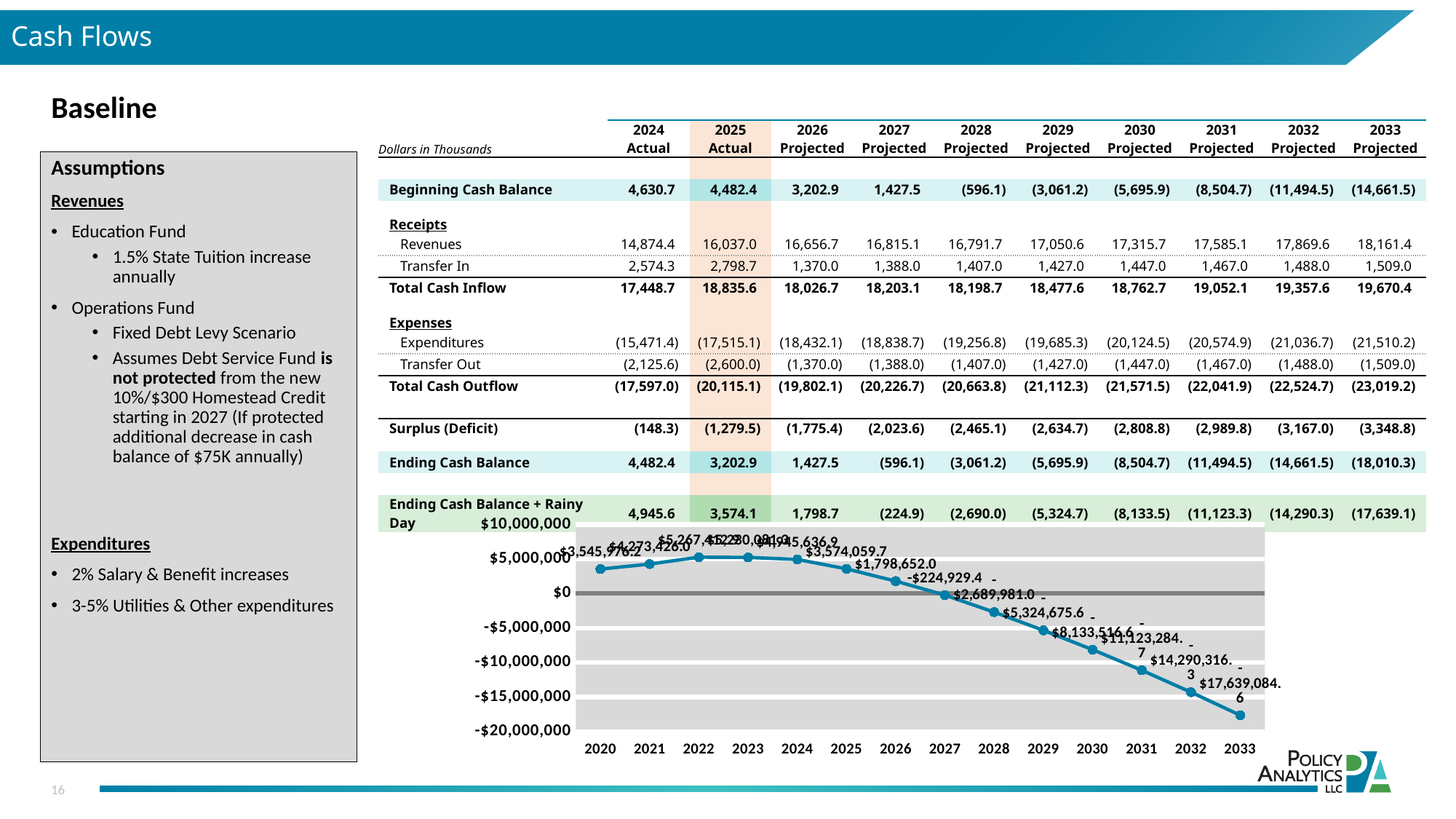
In the line chart, do the values rise or fall from 2024 to 2033? Fall What is the value plotted for 2025 in the line chart? $3,574,059.7 In the line chart, which is larger, the value for 2020 or the value for 2021? 2021 What is the value plotted for 2020 in the line chart? $3,545,976.2 In the line chart, is the value for 2030 greater or less than -$5,000,000? less What kind of chart is shown at the bottom of the slide? Line chart What is the value plotted for 2024 in the line chart? $4,945,636.9 What is the value plotted for 2026 in the line chart? $1,798,652.0 What is the value plotted for 2021 in the line chart? $4,273,426.0 How many years are plotted on the x axis of the line chart? 14 Which year has the lowest value in the line chart? 2033 In the line chart, what is the difference between the 2025 value and the 2026 value? $1,775,407.7